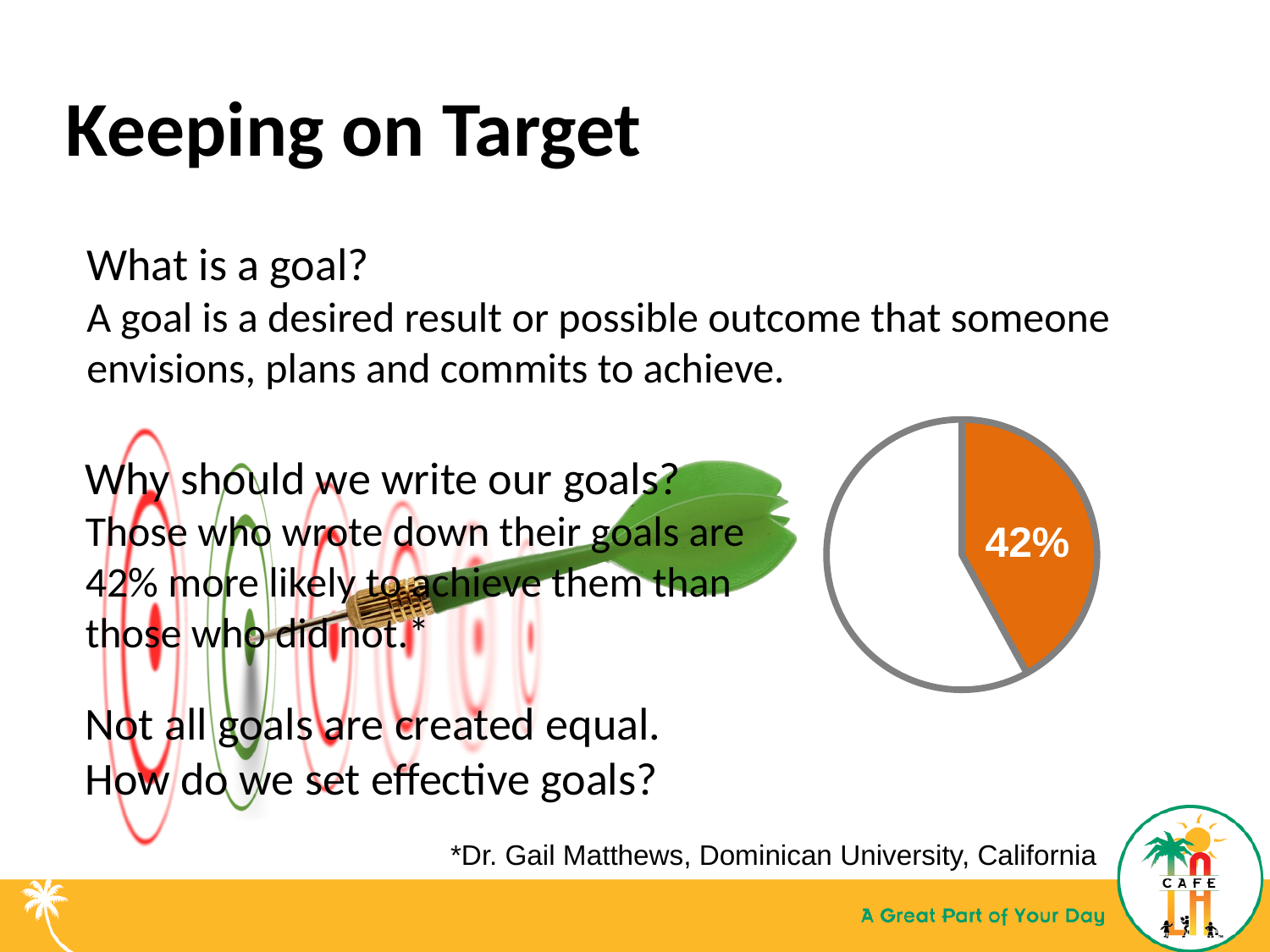
What value is labelled on the orange slice of the pie chart? 42% What kind of chart is shown on the slide? pie chart Does the pie chart have a legend? No Is the orange slice of the pie chart greater or less than 50% of the pie? less Which slice of the pie chart is larger, the orange slice or the white slice? the white slice What colour is the slice of the pie chart that carries the 42% label? orange How many slices does the pie chart have? 2 What share of the pie does the orange slice represent? 42%